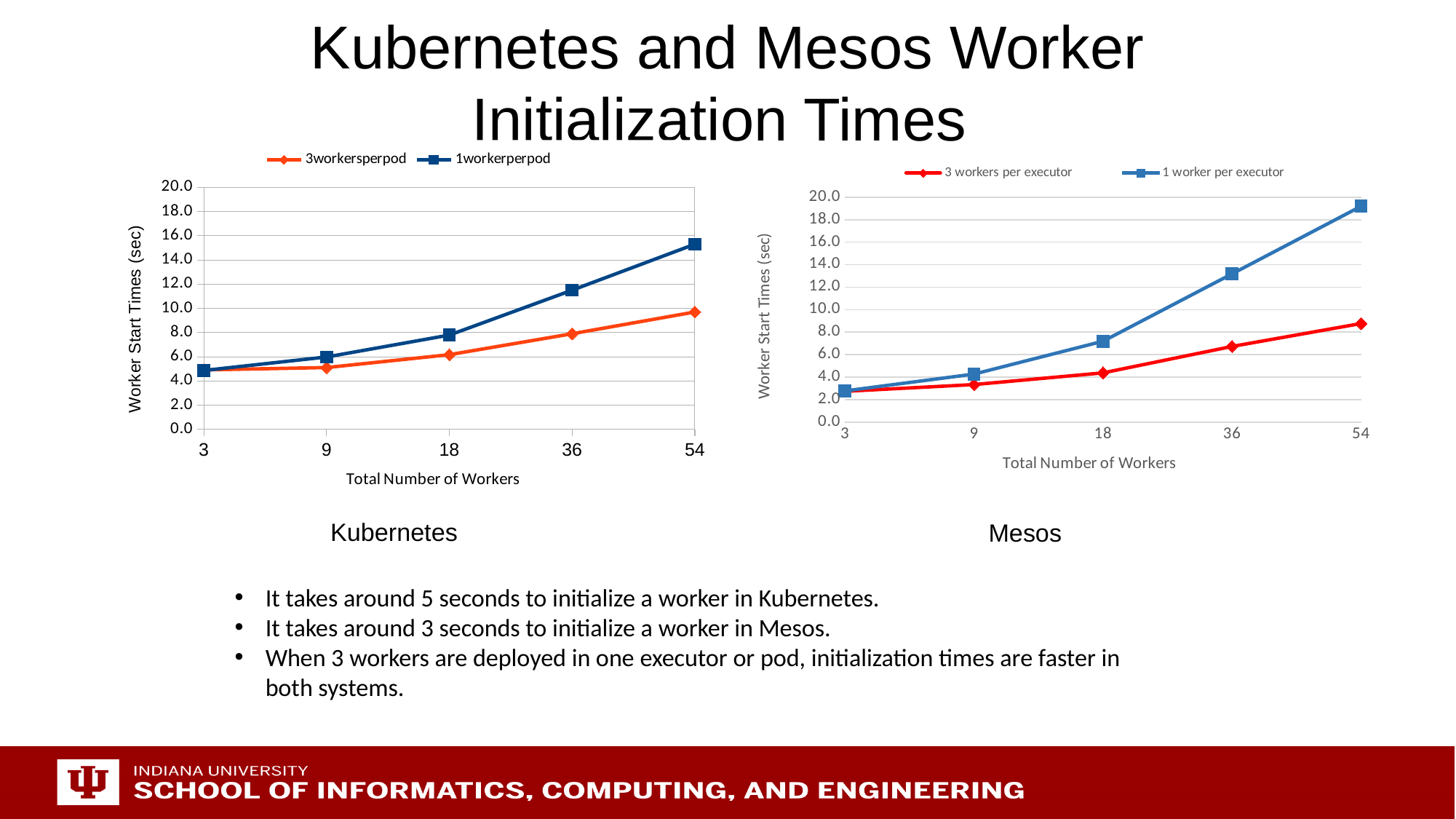
In the Mesos chart, do the values for 1 worker per executor rise or fall as the total number of workers increases? Rise What is the y-axis title of the Mesos chart? Worker Start Times (sec) In the Mesos chart, how many values of Total Number of Workers are plotted along the x axis? 5 In the Kubernetes chart, how many series does the legend list? 2 In the Kubernetes chart, which series has the higher worker start time at 36 workers? 1workerperpod In the Mesos chart, at which total number of workers is the 1 worker per executor value highest? 54 In the Kubernetes chart, is the value for 1workerperpod at 54 workers greater or less than 14.0? greater What kind of chart is the Kubernetes chart on the left? Line chart In the Mesos chart, is the value for 3 workers per executor at 18 workers greater or less than 6.0? less In the Mesos chart, is the value for 1 worker per executor at 54 workers greater or less than 18.0? greater In the Mesos chart, which series has the higher worker start time at 54 workers? 1 worker per executor